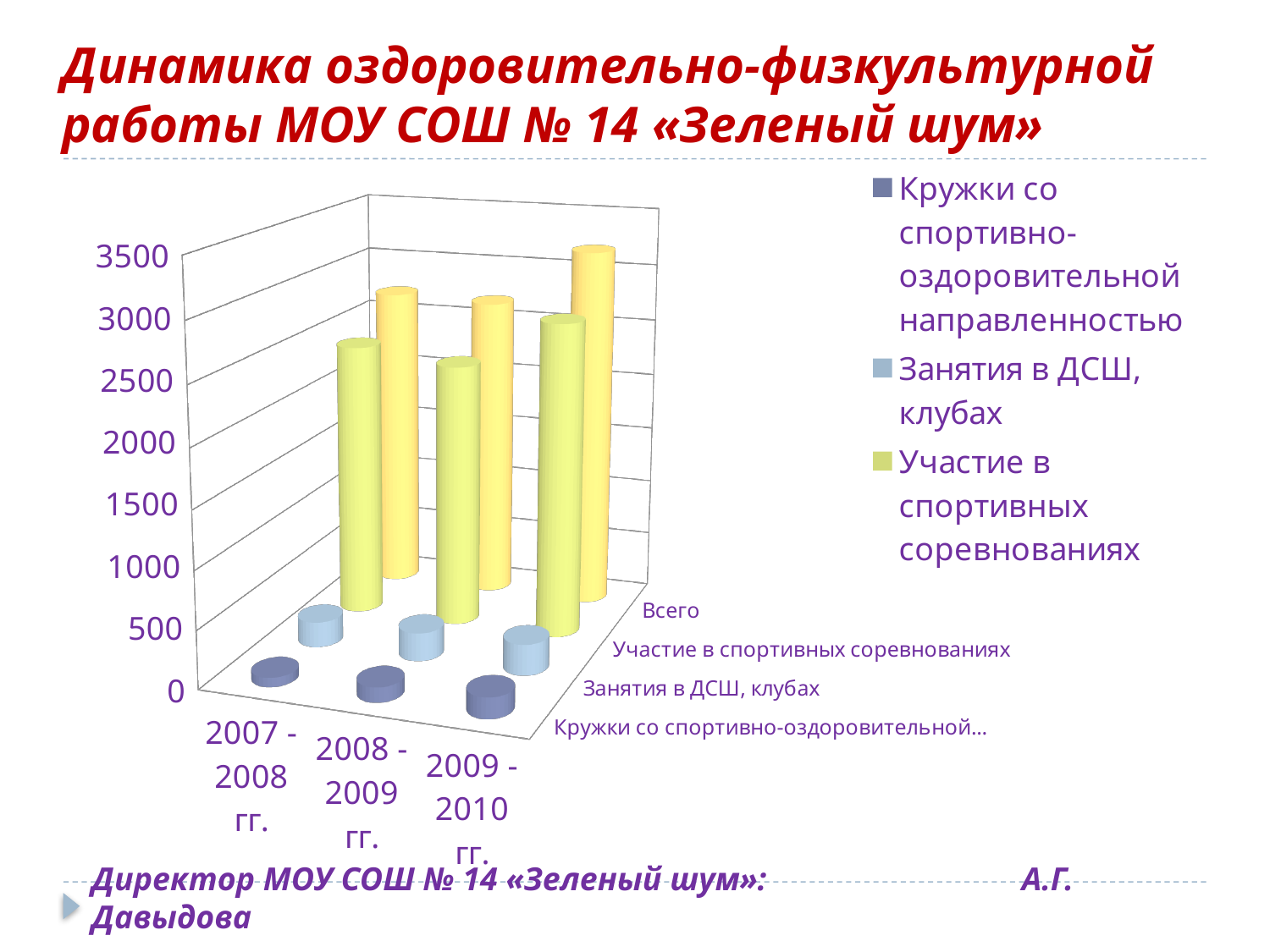
What is the highest value shown on the chart's vertical axis? 3500 Is the value for 'Участие в спортивных соревнованиях' in 2007-2008 greater or less than 1500? greater What kind of chart is shown on the slide? bar chart Which academic years are shown as categories on the chart's x axis? 2007-2008 гг., 2008-2009 гг., 2009-2010 гг. In 2007-2008, which is larger: 'Занятия в ДСШ, клубах' or 'Кружки со спортивно-оздоровительной направленностью'? Занятия в ДСШ, клубах Is the value for 'Участие в спортивных соревнованиях' in 2009-2010 greater or less than 2000? greater In 2009-2010, which is larger: 'Участие в спортивных соревнованиях' or 'Кружки со спортивно-оздоровительной направленностью'? Участие в спортивных соревнованиях How many academic-year categories are shown on the x axis of the chart? 3 Is the value for 'Занятия в ДСШ, клубах' in 2008-2009 greater or less than 1000? less How many series does the chart legend list? 3